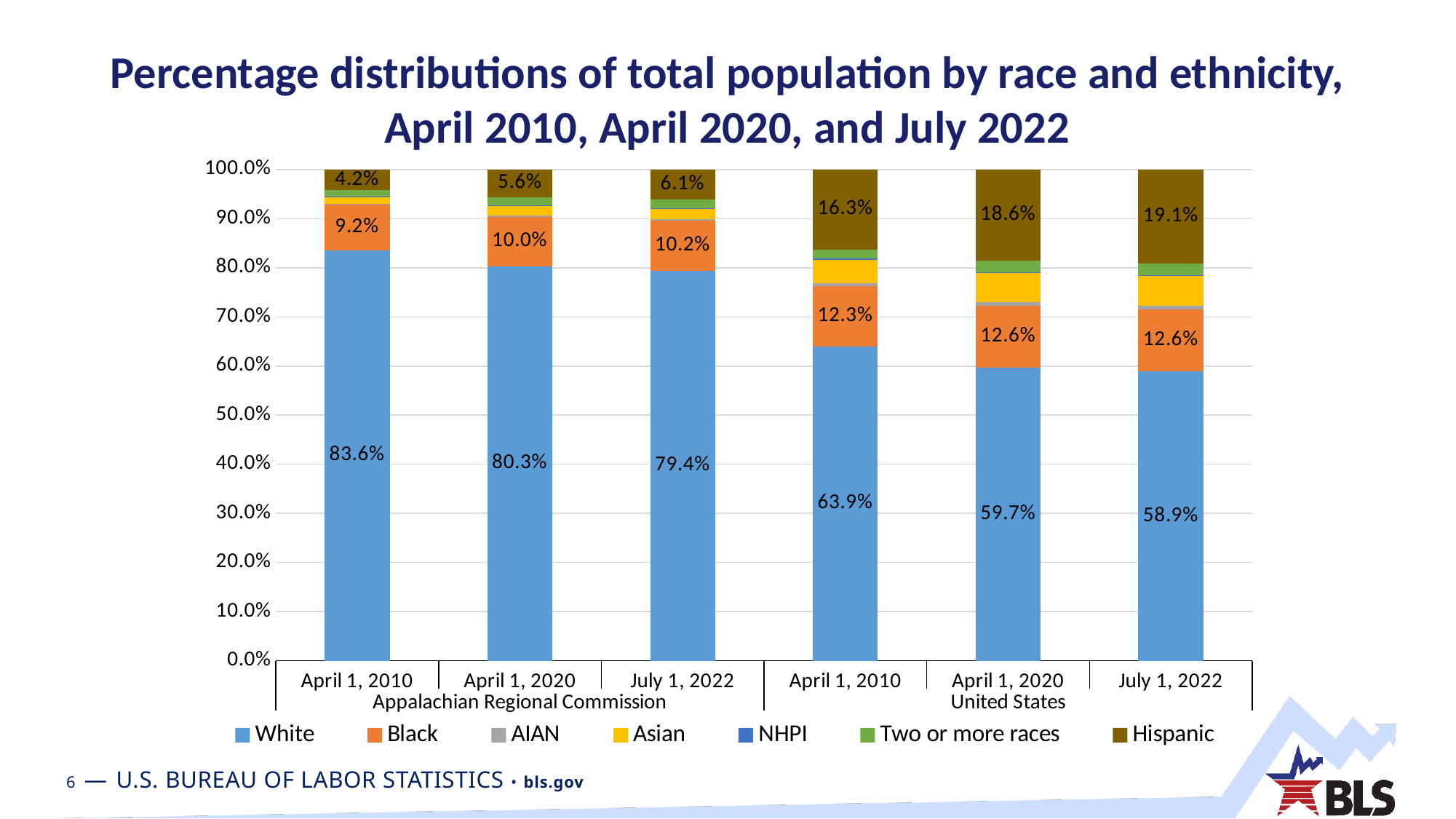
What is the difference between the White share for the United States on April 1, 2010 and on July 1, 2022? 5.0% What is the Hispanic share of the population for the United States on July 1, 2022? 19.1% Which bar has the lowest Hispanic share? Appalachian Regional Commission, April 1, 2010 How many series does the legend list? 7 Is the Hispanic share larger for the United States on April 1, 2020 or for the Appalachian Regional Commission on April 1, 2020? United States, April 1, 2020 Does the White share for the Appalachian Regional Commission rise or fall from April 1, 2010 to July 1, 2022? fall What kind of chart is shown on the slide? Stacked bar chart What is the Black share of the population for the Appalachian Regional Commission on April 1, 2020? 10.0% How many bars are shown in the chart? 6 What is the White share of the population for the Appalachian Regional Commission on April 1, 2010? 83.6% Is the White share for the United States on July 1, 2022 greater or less than 60.0%? less Which bar has the highest White share? Appalachian Regional Commission, April 1, 2010